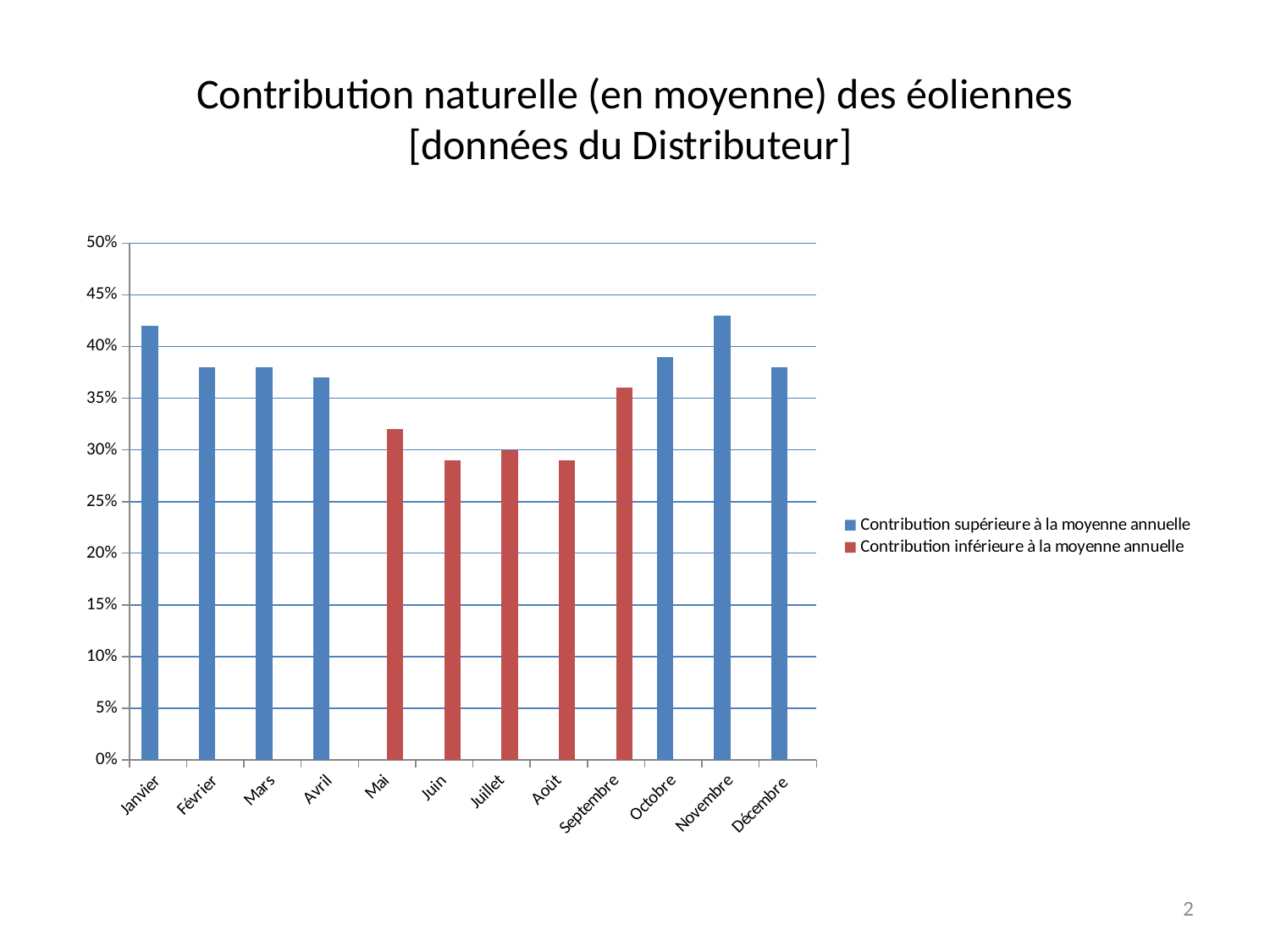
Which month has the highest value in the chart? Novembre Which is larger, the value for Janvier or the value for Mai? Janvier Is the value for Mai greater or less than 30%? greater How many months are shown on the x axis of the chart? 12 How many series does the legend list? 2 Which colour is used for the series 'Contribution inférieure à la moyenne annuelle'? red What kind of chart is shown on the slide? bar chart Is the value for Janvier greater or less than 40%? greater Do the values rise or fall from Janvier to Juin? fall Is the value for Juillet greater or less than 35%? less